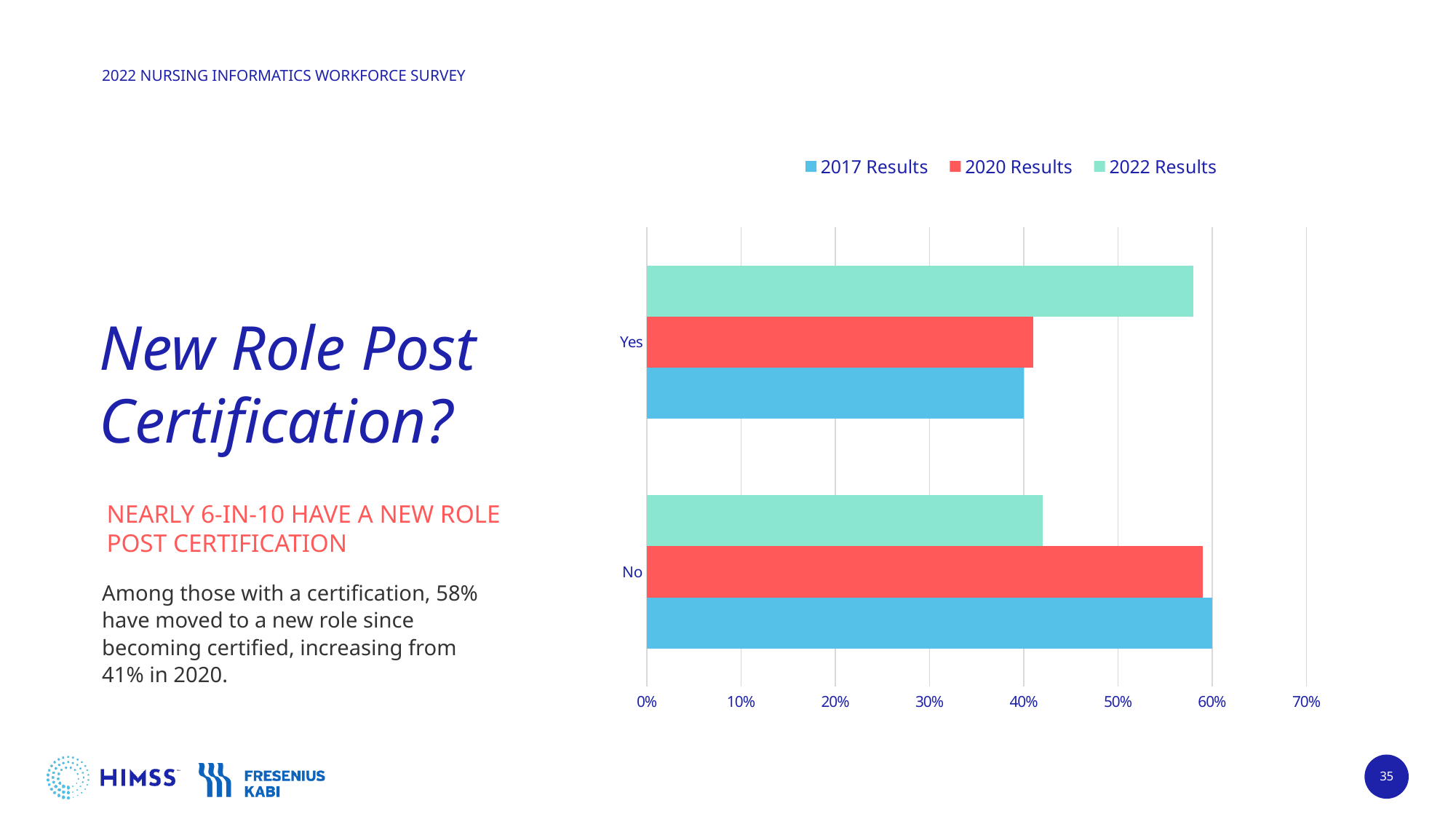
For the "No" category, which series has the lowest value? 2022 Results Is the value of the 2022 Results bar for "Yes" greater or less than 50%? greater What kind of chart is shown on the slide? bar chart How many categories are shown on the vertical axis of the chart? 2 Is the value of the 2022 Results bar for "No" greater or less than 50%? less How many series does the legend list? 3 What is the value of the 2017 Results bar for "Yes"? 40% For the "No" category, which is larger: the 2017 Results bar or the 2022 Results bar? 2017 Results What is the value of the 2017 Results bar for "No"? 60% For the "Yes" category, which series has the highest value? 2022 Results Is the value of the 2020 Results bar for "Yes" greater or less than 50%? less What is the highest value shown on the horizontal axis of the chart? 70%